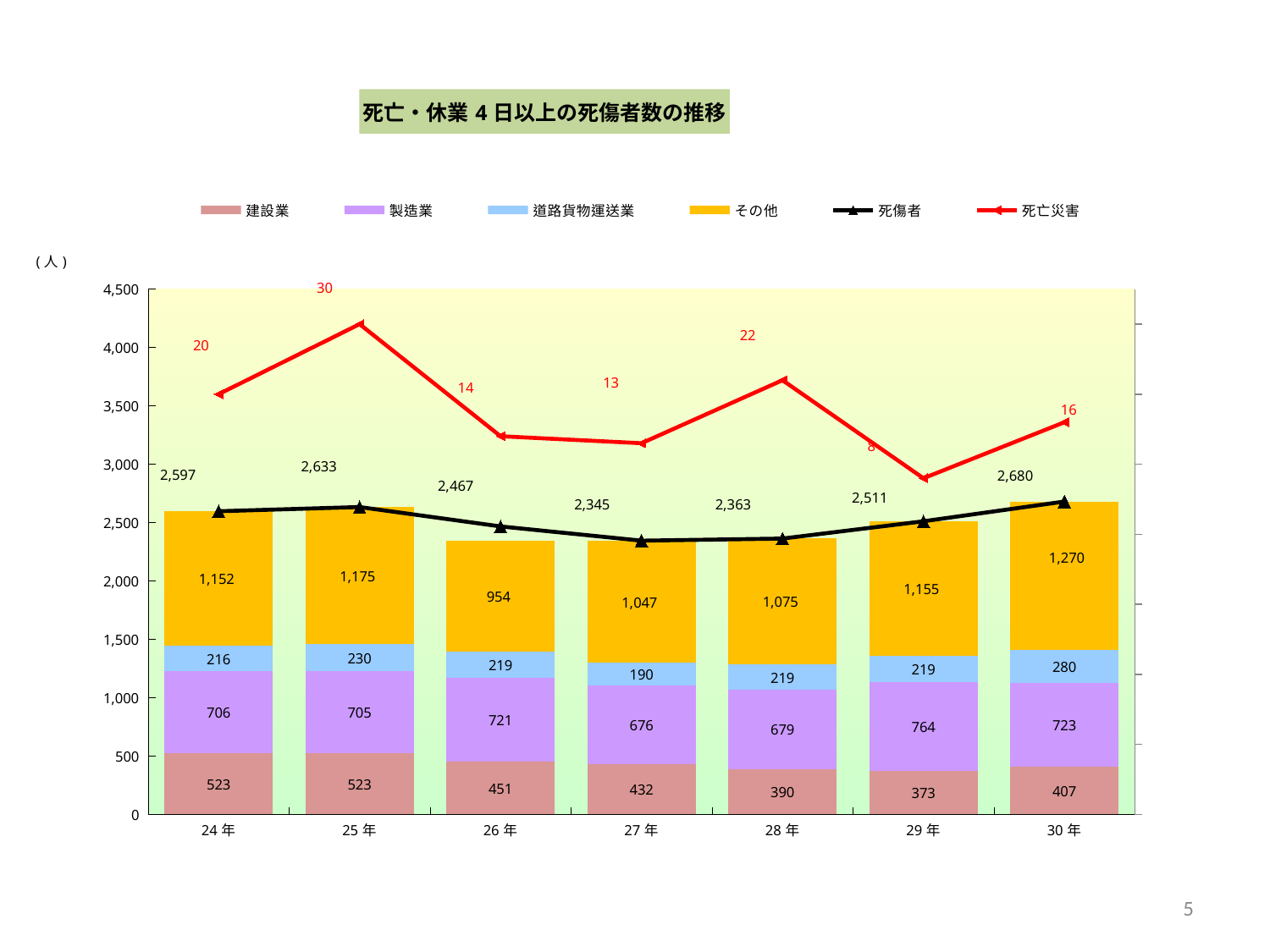
What is the 死亡災害 value in 25年? 30 In which year is the 死傷者 value the highest? 30年 What kind of chart is this? Stacked bar chart with line series How many years are shown on the x axis? 7 Which is larger, the 道路貨物運送業 value in 30年 or in 25年? 30年 What is the title of the chart? 死亡・休業4日以上の死傷者数の推移 What is the value for 建設業 in 24年? 523 What is the difference between the 製造業 values in 29年 and 27年? 88 How many series does the legend list? 6 What is the value for その他 in 30年? 1,270 In which year is the 死亡災害 value the lowest? 29年 What is the 死傷者 value in 27年? 2,345